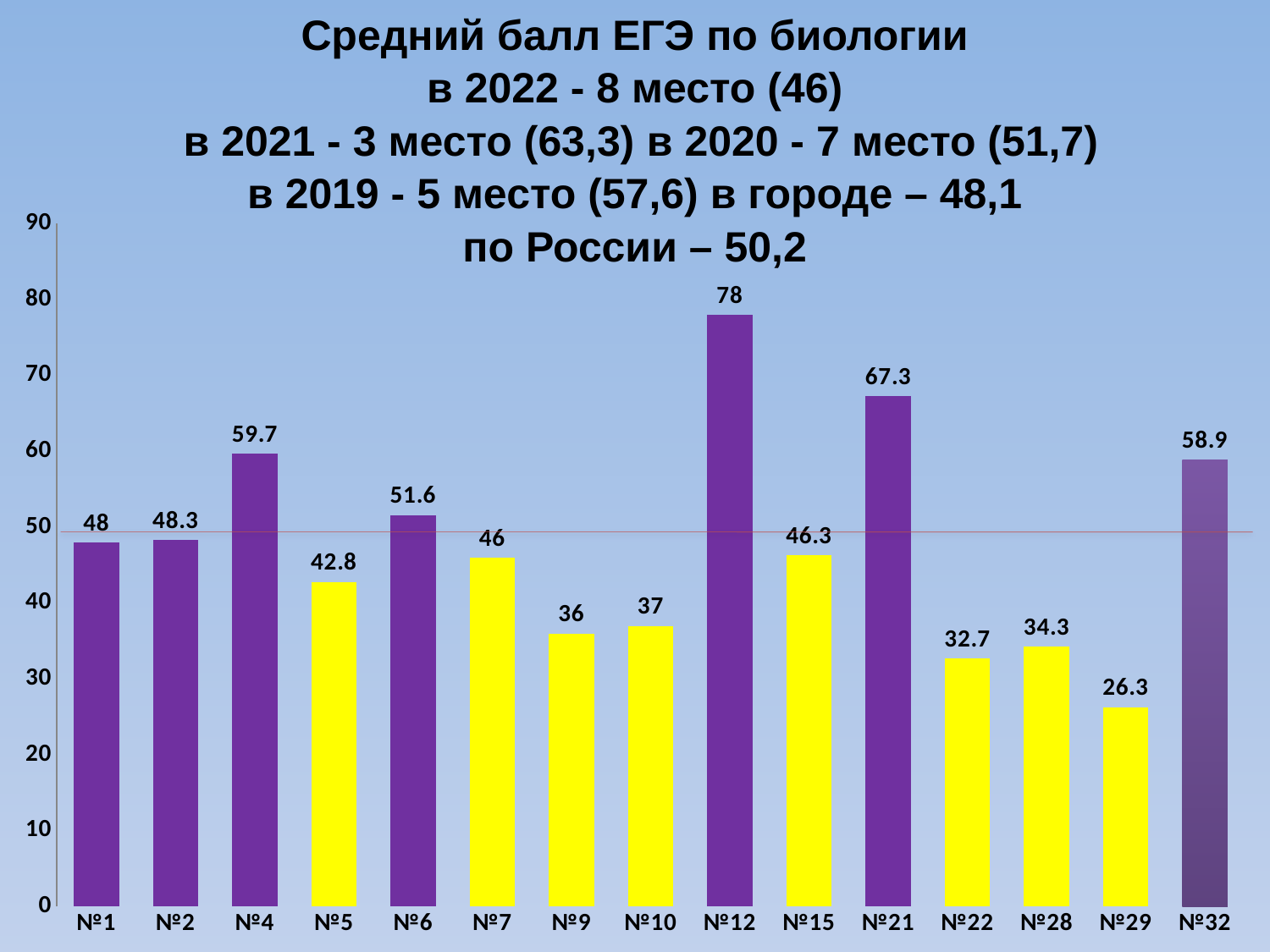
Which category has the highest value? №12 How many categories are shown on the x axis? 15 Is the value for №21 greater or less than 60? greater What is the value for №12? 78 What is the value for №6? 51.6 What colour are the bars for №5, №7 and №9? yellow What is the difference between the values for №4 and №32? 0.8 Which is larger, the value for №22 or the value for №28? №28 What is the difference between the values for №12 and №21? 10.7 What is the value for №29? 26.3 What kind of chart is shown on the slide? bar chart Which category has the lowest value? №29